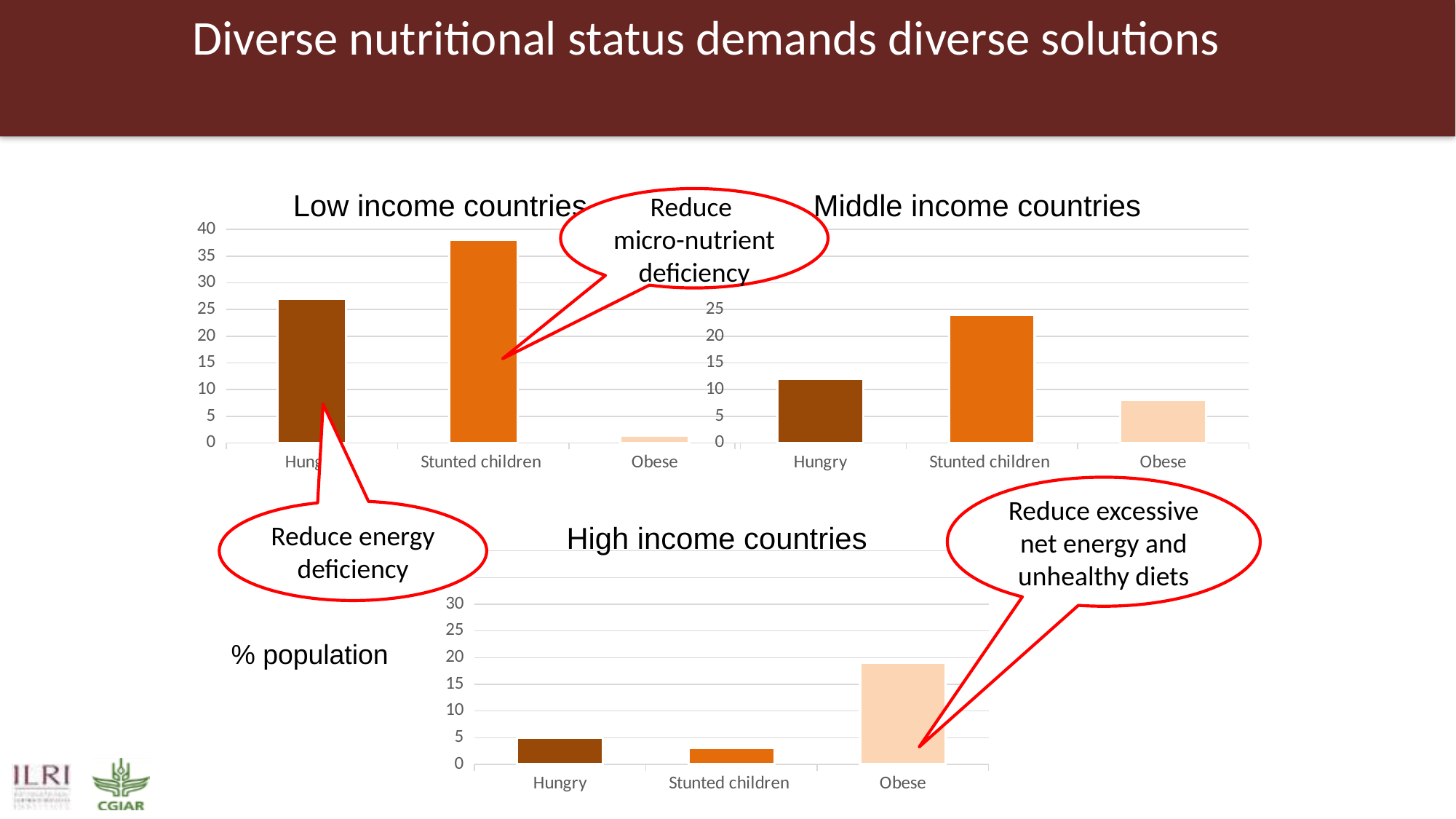
In the High income countries chart, is the value for Obese greater or less than 15? greater In the Low income countries chart, which category has the highest value? Stunted children How many categories are shown on the x axis of the High income countries chart? 3 In the Middle income countries chart, which category has the highest value? Stunted children In the Low income countries chart, is the value for Stunted children greater or less than 35? greater In the Middle income countries chart, which is larger, Hungry or Obese? Hungry What type of chart is the Middle income countries chart? Bar chart In the High income countries chart, which category has the highest value? Obese In the Middle income countries chart, is the value for Obese greater or less than 10? less In the High income countries chart, which category has the lowest value? Stunted children In the Low income countries chart, which category has the lowest value? Obese